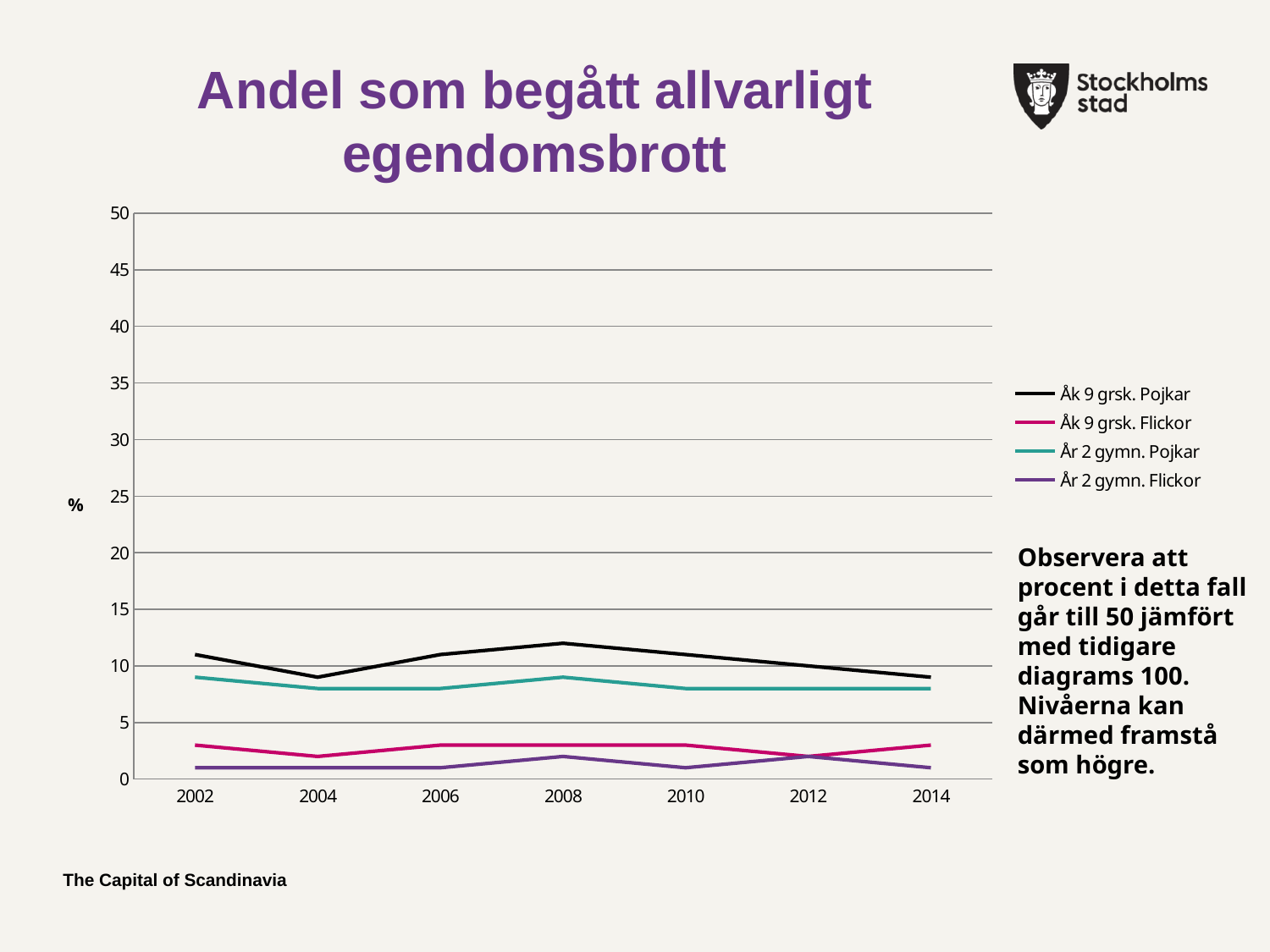
Which series has the lowest value in 2002? År 2 gymn. Flickor Which is larger in 2008, the value for Åk 9 grsk. Pojkar or the value for År 2 gymn. Flickor? Åk 9 grsk. Pojkar What is the title of the chart? Andel som begått allvarligt egendomsbrott How many series does the legend list? 4 Which series has the highest values across the whole period? Åk 9 grsk. Pojkar Is the value for Åk 9 grsk. Flickor in 2002 greater or less than 5? less Is the value for År 2 gymn. Pojkar in 2004 greater or less than 10? less What kind of chart is shown on the slide? line chart Does the value for Åk 9 grsk. Pojkar rise or fall from 2008 to 2014? fall Is the value for Åk 9 grsk. Pojkar in 2008 greater or less than 10? greater How many years are plotted along the x axis? 7 What is the label on the y axis? %